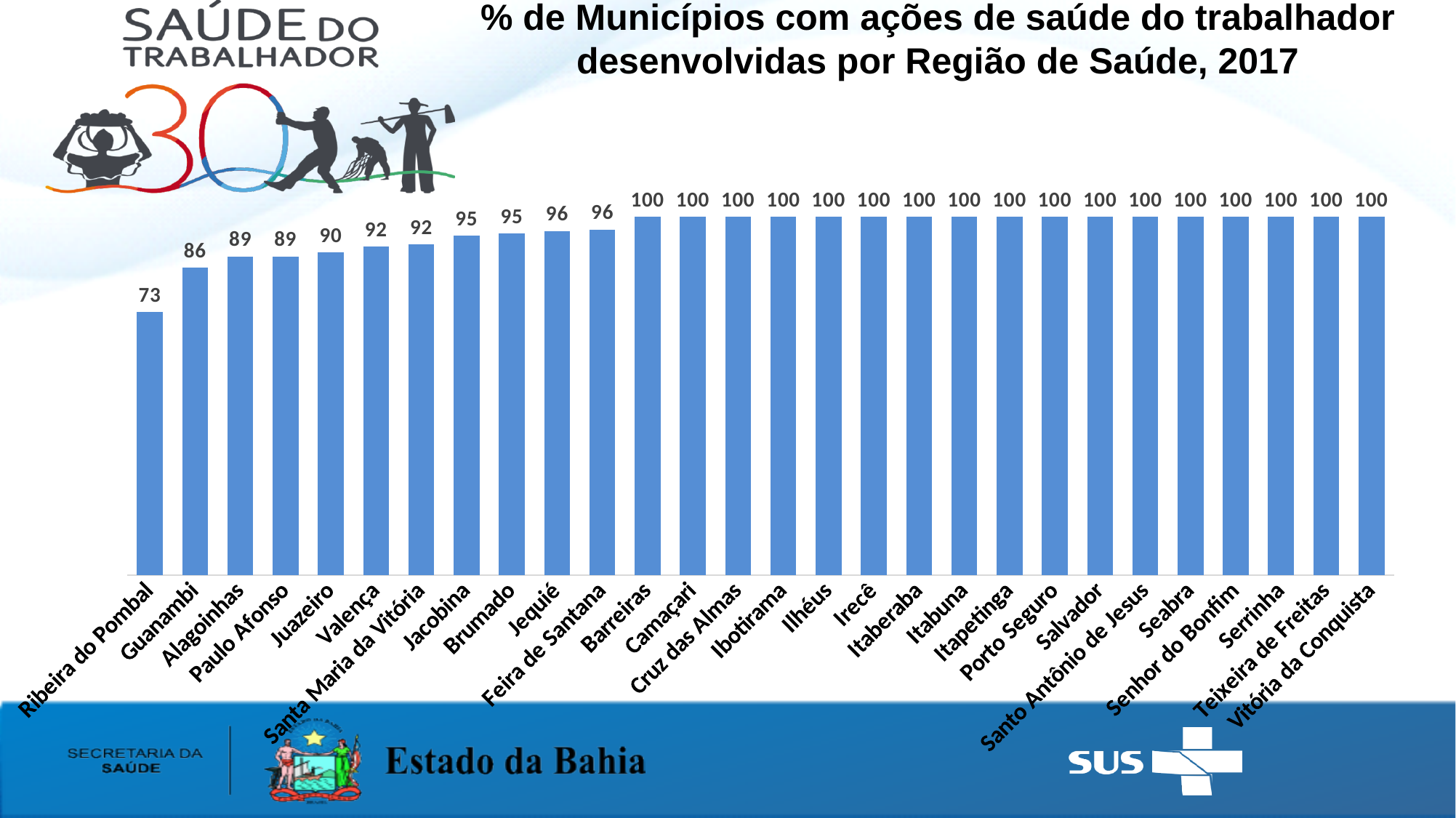
How many regions have a value of 100? 17 What is the value for Ribeira do Pombal? 73 What is the value for Jacobina? 95 Which has a larger value, Guanambi or Valença? Valença What is the value for Juazeiro? 90 Do the values rise or fall from left to right along the x axis? Rise What is the value for Guanambi? 86 What is the difference between the values for Barreiras and Ribeira do Pombal? 27 What kind of chart is this? Bar chart What is the value for Feira de Santana? 96 Which region has the lowest value? Ribeira do Pombal How many regions are shown on the chart? 28